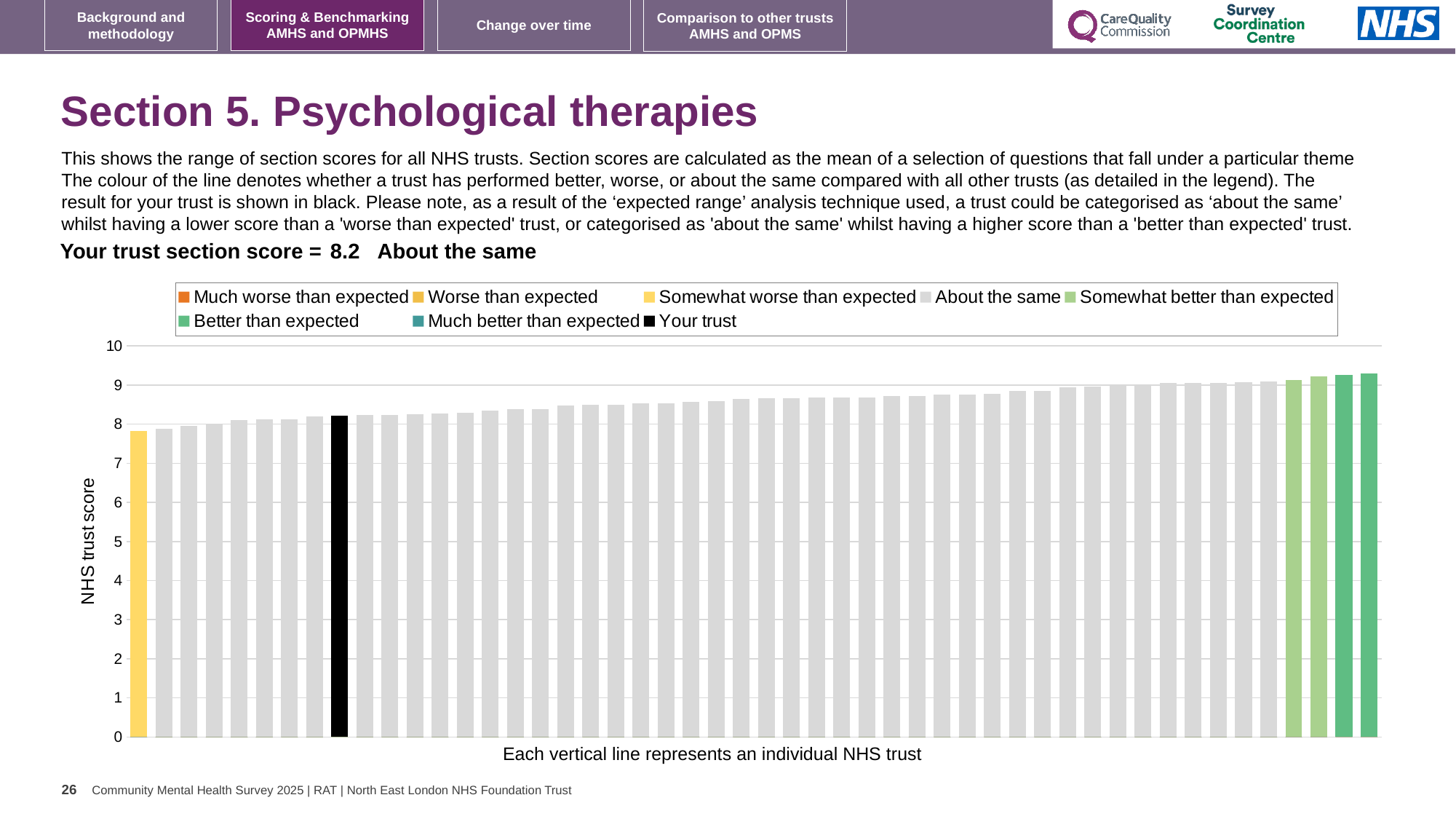
What kind of chart is shown on the slide? bar chart Which is higher, the black bar for your trust or the yellow bar at the far left? the black bar for your trust What is the section score for your trust shown on the slide? 8.2 Which legend category does the highest bar on the chart belong to? Better than expected Is the value of the leftmost (lowest) bar greater or less than 8? less According to the slide, which category is your trust's section score in? About the same Do the bar values rise or fall from left to right along the x axis? rise How many entries does the chart legend list? 8 Is the value of the rightmost (highest) bar greater or less than 9? greater What colour is the lowest bar on the chart? yellow What is the title of the vertical axis? NHS trust score Is the value for your trust (the black bar) greater or less than 8? greater